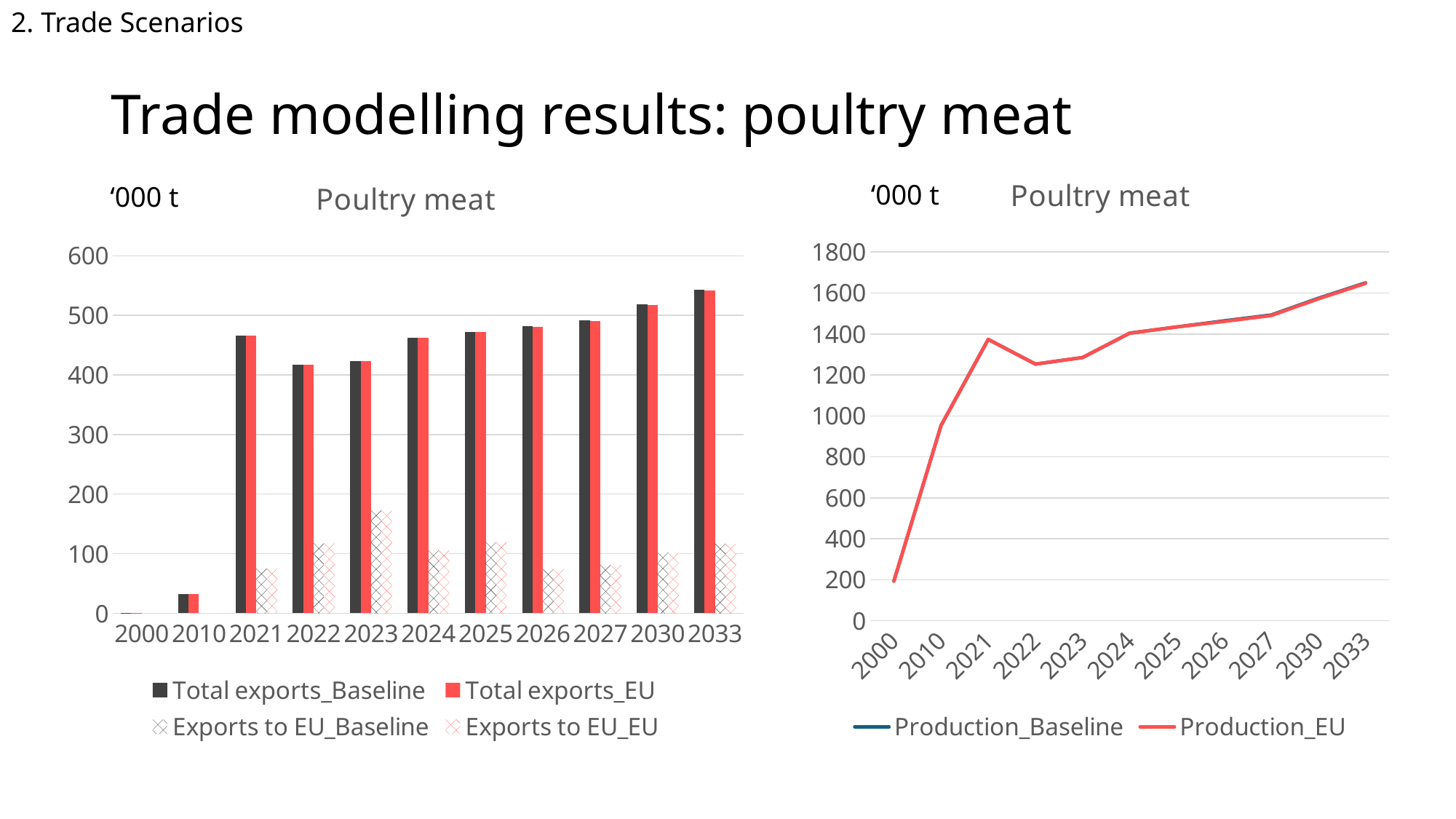
How many years are shown on the x axis of the left chart? 11 What kind of chart is the left chart on the slide? bar chart How many series does the legend of the right chart list? 2 In the left chart, which year has the highest Exports to EU_Baseline value? 2023 In the left chart, is the Total exports_Baseline value for 2010 greater or less than 100? less In the left chart, which year has the highest Total exports_Baseline value? 2033 In the right chart, is the Production_EU value for 2033 greater or less than 1600? greater In the left chart, is the Total exports_Baseline value for 2033 greater or less than 500? greater What kind of chart is the right chart on the slide? line chart In the left chart, which is larger: Total exports_Baseline in 2021 or in 2022? 2021 In the right chart, does Production_EU overall rise or fall from 2000 to 2033? rise How many series does the legend of the left chart list? 4